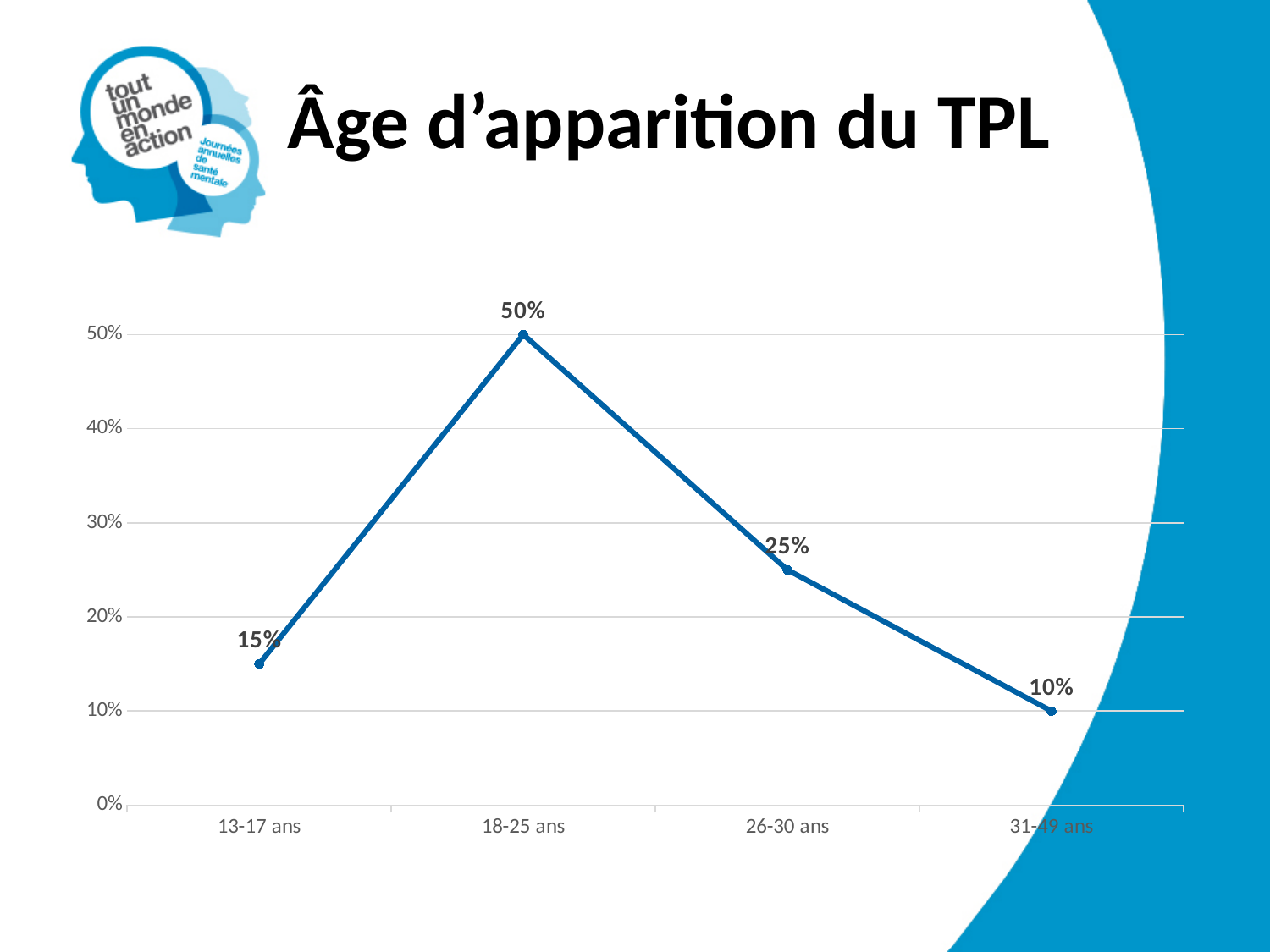
Do the values rise or fall from 18-25 ans to 31-49 ans? Fall What is the value for the 26-30 ans age group? 25% Which is larger, the value for 13-17 ans or the value for 26-30 ans? 26-30 ans Which age group has the lowest value? 31-49 ans Which age group has the highest value? 18-25 ans What is the value for the 31-49 ans age group? 10% How many age groups are plotted on the chart? 4 What is the title of the slide containing the chart? Âge d’apparition du TPL What kind of chart is shown on the slide? Line chart What is the difference between the values for 18-25 ans and 26-30 ans? 25% What is the value for the 13-17 ans age group? 15% What is the value for the 18-25 ans age group? 50%